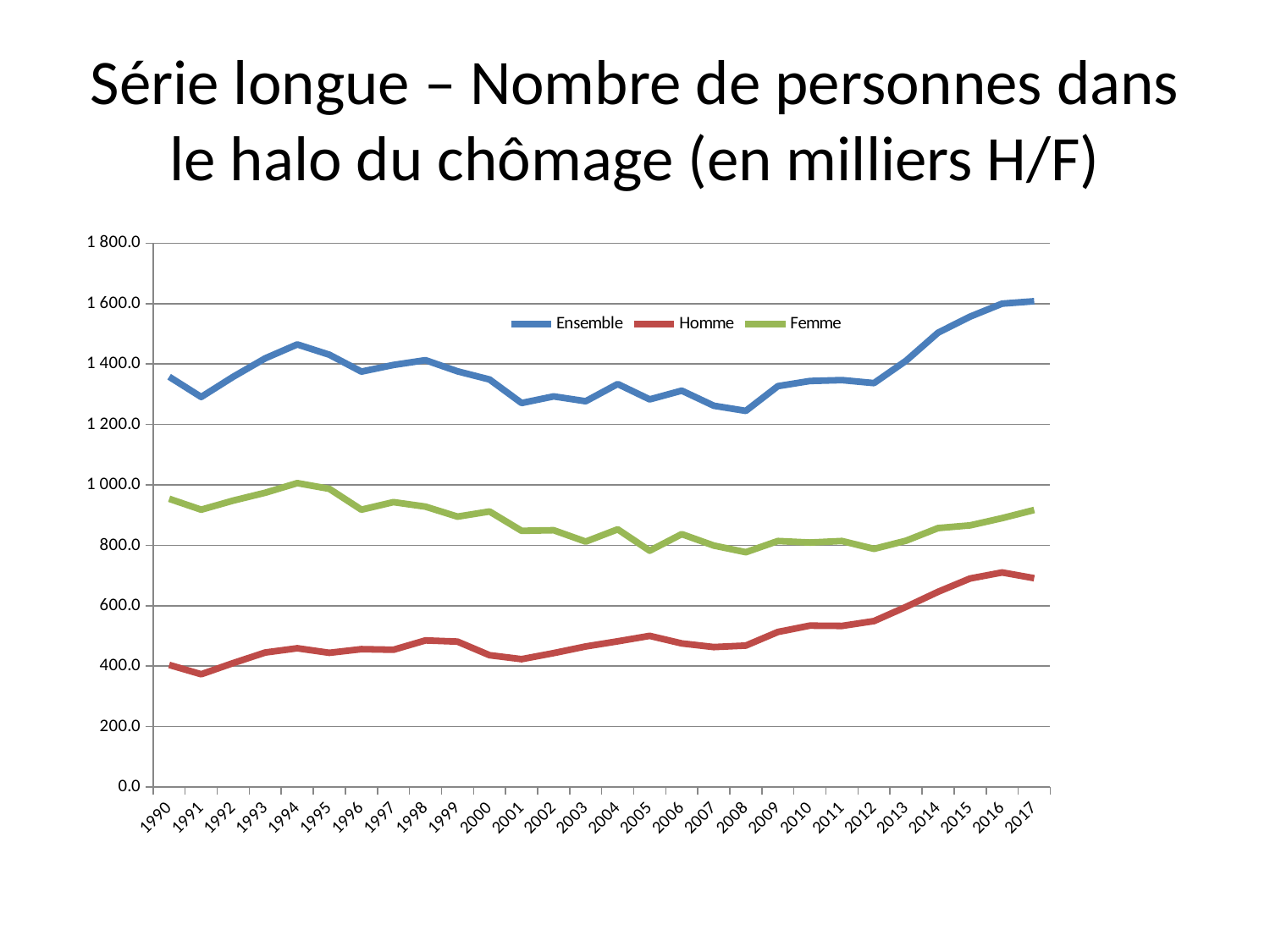
What kind of chart is shown on the slide? line chart In 2000, which series has the larger value, Homme or Femme? Femme Is the value for Ensemble in 2008 greater or less than 1 400.0? less Does the Femme series rise or fall overall between 1994 and 2008? fall Is the value for Ensemble in 2017 greater or less than 1 400.0? greater Does the Homme series rise or fall between 2008 and 2016? rise Is the value for Homme in 1991 greater or less than 400.0? less In which year is the Homme series at its lowest? 1991 What colour is the Ensemble line? blue How many years are plotted along the x axis? 28 How many series does the legend list? 3